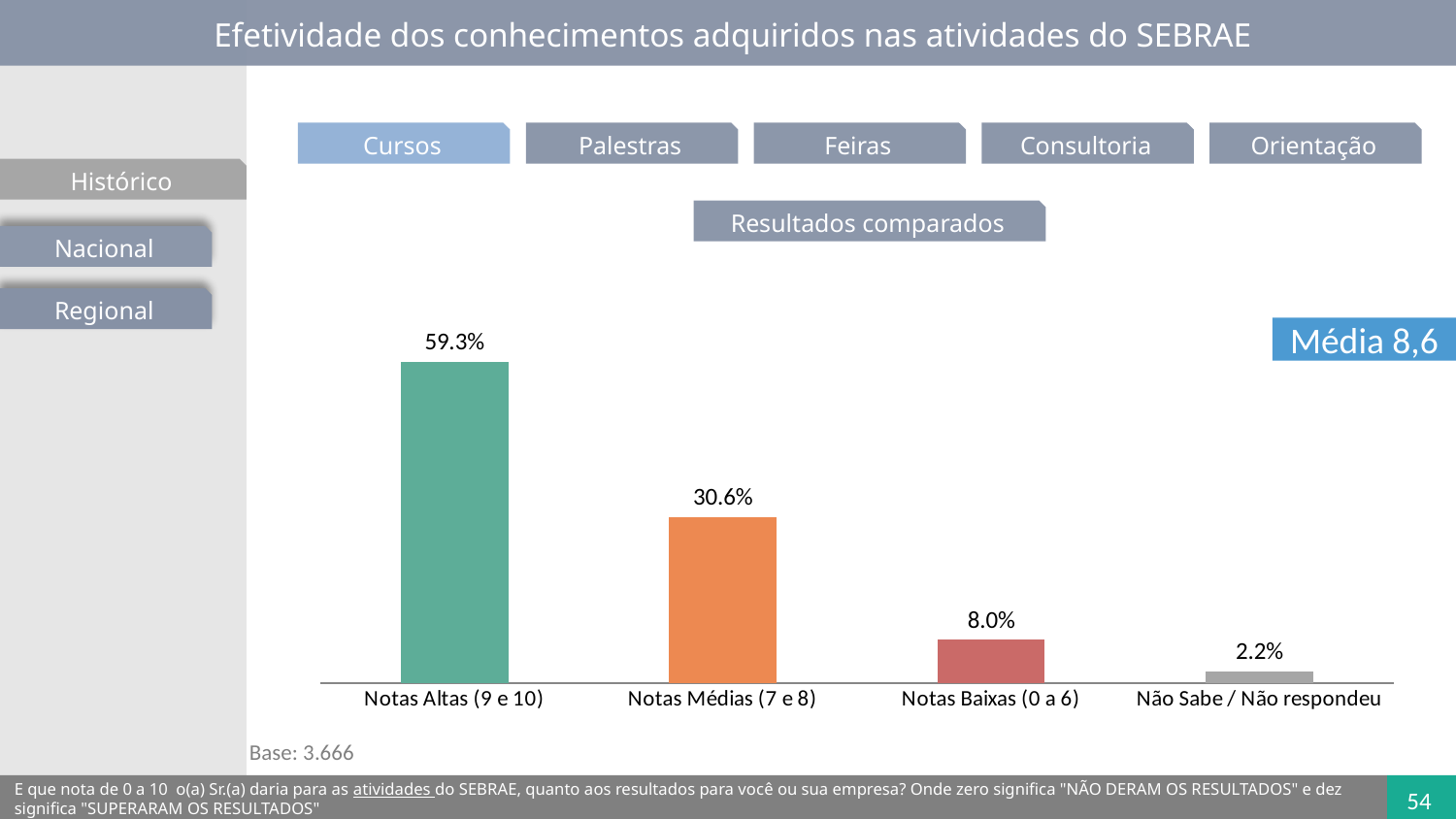
What is the value for Notas Altas (9 e 10)? 59.3% Which is larger, Notas Médias (7 e 8) or Notas Baixas (0 a 6)? Notas Médias (7 e 8) Which category has the highest value? Notas Altas (9 e 10) Which category has the lowest value? Não Sabe / Não respondeu What is the difference between Notas Altas (9 e 10) and Notas Médias (7 e 8)? 28.7% What is the value for Notas Médias (7 e 8)? 30.6% What is the value for Não Sabe / Não respondeu? 2.2% What is the difference between Notas Baixas (0 a 6) and Não Sabe / Não respondeu? 5.8% What kind of chart is shown on the slide? Bar chart What average (Média) is shown next to the chart? 8,6 What is the value for Notas Baixas (0 a 6)? 8.0% How many categories are shown in the chart? 4